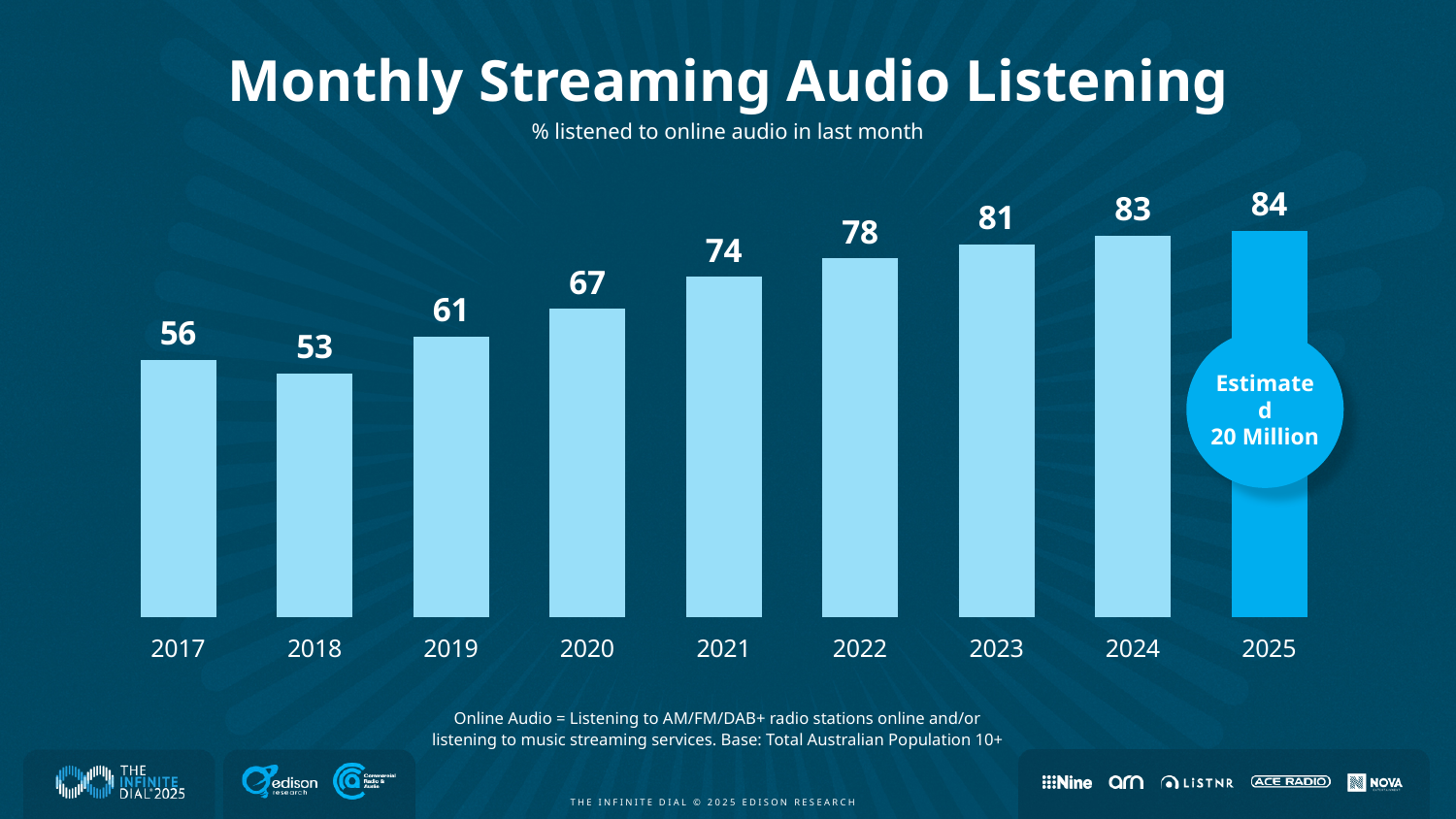
What kind of chart is this? bar chart Do the values generally rise or fall from 2018 to 2025? rise Which is larger, the value for 2020 or the value for 2022? 2022 What is the title of the chart? Monthly Streaming Audio Listening Which year has the highest value? 2025 What is the value for 2021? 74 What is the value for 2025? 84 Which year has the lowest value? 2018 What is the value for 2017? 56 How many years are shown on the chart? 9 What is the difference between the values for 2019 and 2018? 8 What is the difference between the values for 2025 and 2017? 28